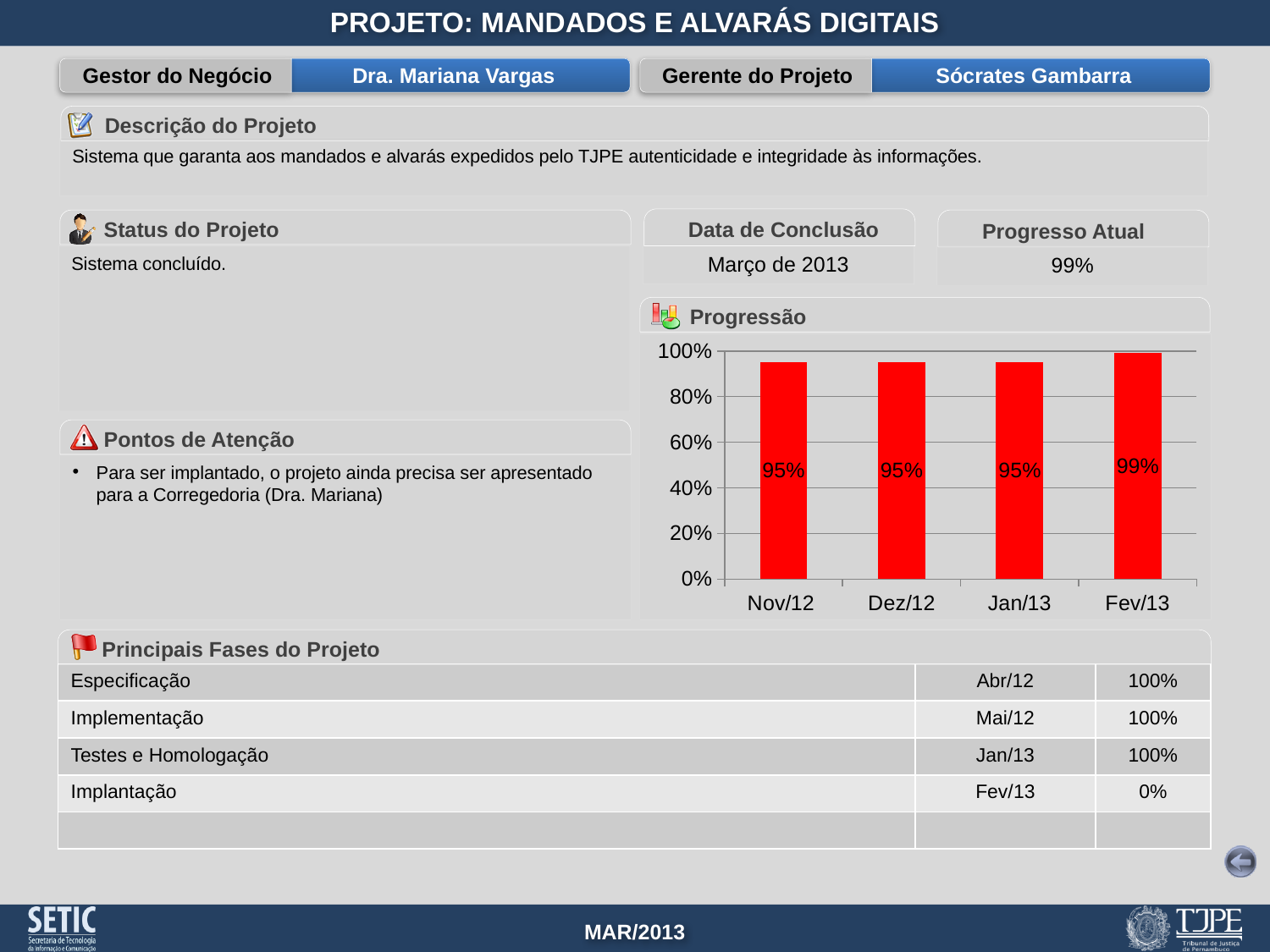
What is the title of the chart on the slide? Progressão Do the values in the Progressão chart rise or fall from Jan/13 to Fev/13? rise How many months are shown on the x axis of the Progressão chart? 4 What colour are the bars in the Progressão chart? red Which month has the highest value in the Progressão chart? Fev/13 What is the value for Nov/12 in the Progressão chart? 95% What kind of chart is the Progressão chart? bar chart What is the value for Jan/13 in the Progressão chart? 95% Which is larger in the Progressão chart, the value for Fev/13 or the value for Nov/12? Fev/13 What is the value for Fev/13 in the Progressão chart? 99% What is the difference between the values for Fev/13 and Dez/12 in the Progressão chart? 4% Is the value for Dez/12 in the Progressão chart greater or less than 80%? greater